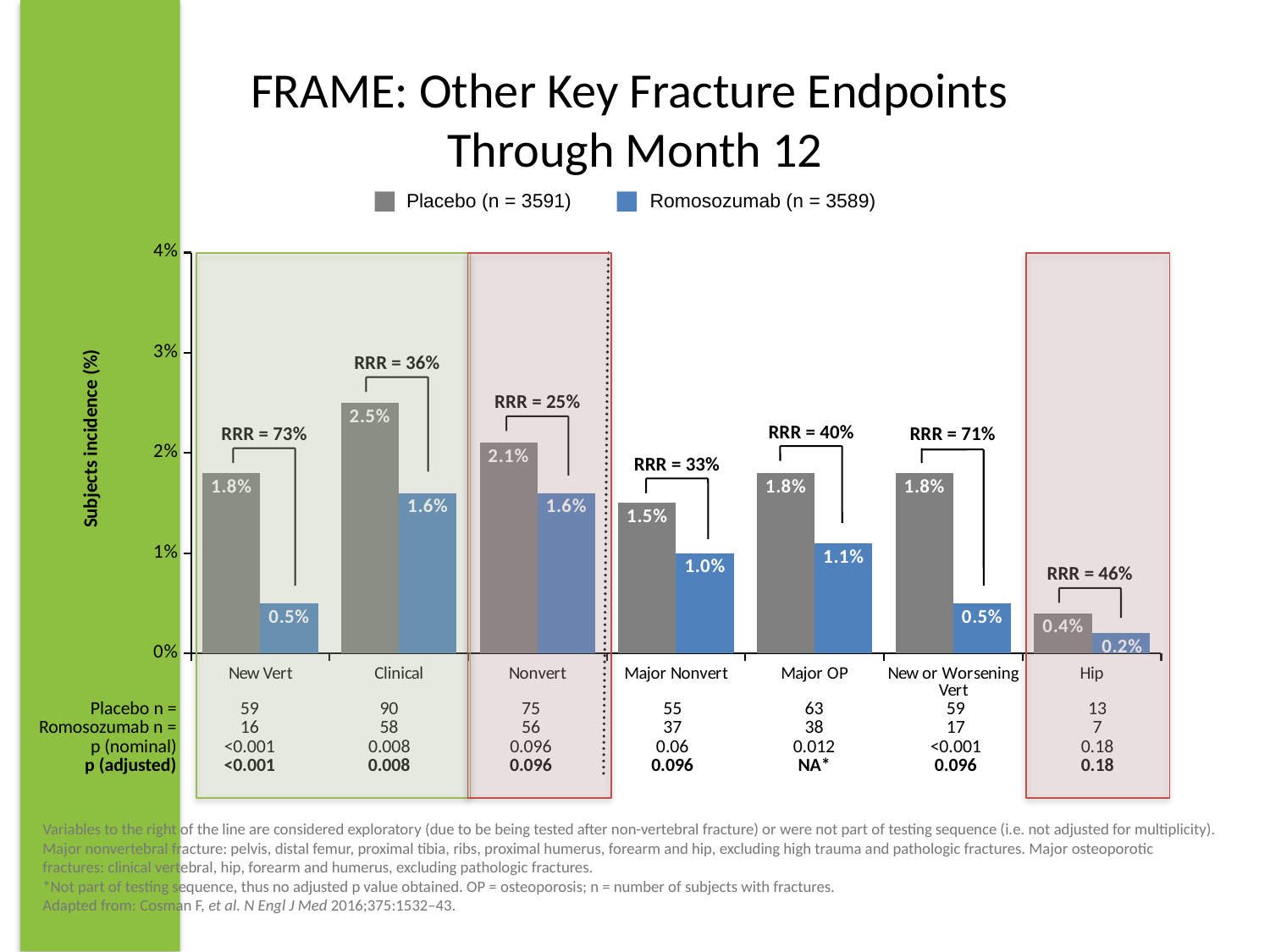
What is the RRR shown for New Vert fractures? 73% Which fracture category has the highest Placebo incidence? Clinical What is the Romosozumab subject incidence for New Vert fractures? 0.5% What kind of chart is shown on the slide? Bar chart What is the Romosozumab subject incidence for Major OP fractures? 1.1% Which fracture category has the lowest Romosozumab incidence? Hip How many fracture categories are shown on the x axis? 7 How many series does the legend list? 2 For Major Nonvert fractures, which group has the higher incidence, Placebo or Romosozumab? Placebo What is the Placebo subject incidence for Clinical fractures? 2.5% What is the difference between the Placebo and Romosozumab incidence for Nonvert fractures? 0.5% Is the Placebo incidence for Clinical fractures greater or less than 2%? greater